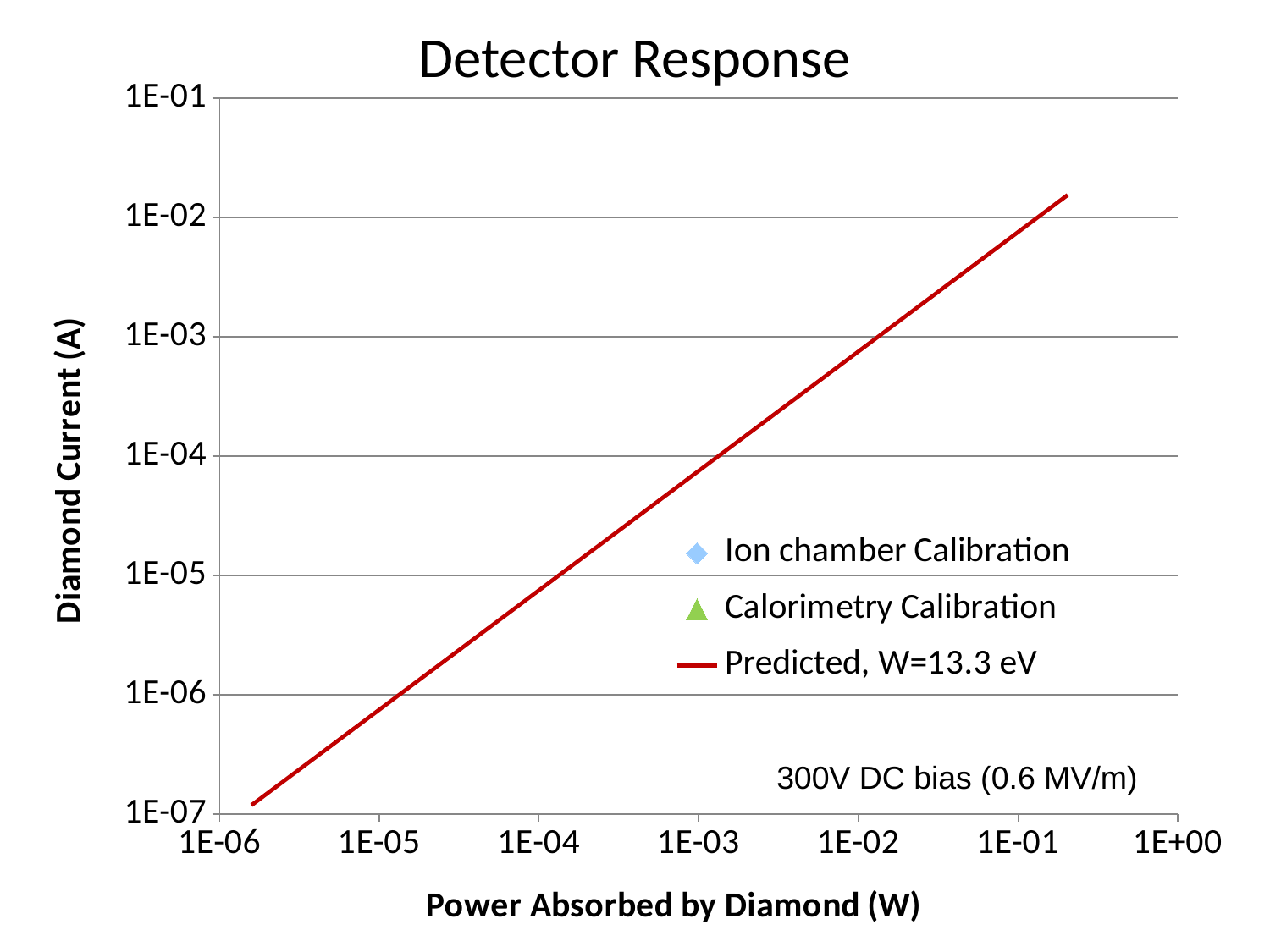
What is the label of the y axis? Diamond Current (A) Is the Diamond Current of the Predicted, W=13.3 eV line at 1E-04 W greater or less than 1E-03 A? less What kind of chart is shown on the slide? line chart How many series does the legend list? 3 Does the Predicted, W=13.3 eV line rise or fall as Power Absorbed by Diamond increases? rise Is the Diamond Current of the Predicted, W=13.3 eV line at 1E-02 W greater or less than 1E-05 A? greater Is the Diamond Current of the Predicted, W=13.3 eV line at 1E-01 W greater or less than 1E-03 A? greater What is the title of the chart? Detector Response